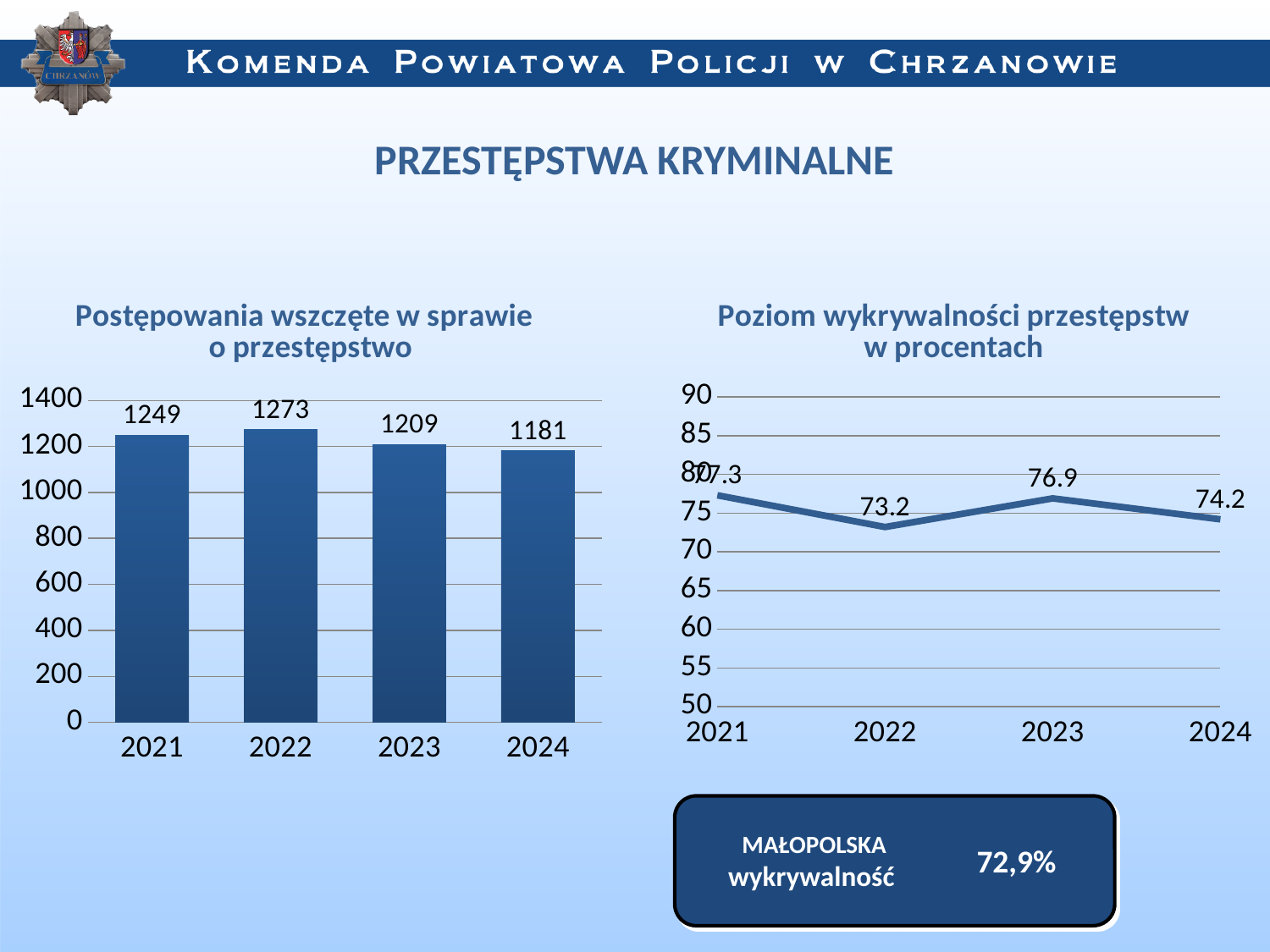
In the chart titled "Postępowania wszczęte w sprawie o przestępstwo", what is the difference between the values for 2022 and 2024? 92 In the chart titled "Poziom wykrywalności przestępstw w procentach", what is the value for 2023? 76.9 In the chart titled "Postępowania wszczęte w sprawie o przestępstwo", how many years are shown? 4 In the chart titled "Poziom wykrywalności przestępstw w procentach", what is the value for 2022? 73.2 In the chart titled "Postępowania wszczęte w sprawie o przestępstwo", what is the value for 2022? 1273 What kind of chart is the one titled "Postępowania wszczęte w sprawie o przestępstwo"? bar chart In the chart titled "Postępowania wszczęte w sprawie o przestępstwo", what is the value for 2024? 1181 In the chart titled "Poziom wykrywalności przestępstw w procentach", is the value for 2021 greater or less than 75? greater In the chart titled "Postępowania wszczęte w sprawie o przestępstwo", which year has the highest value? 2022 In the chart titled "Postępowania wszczęte w sprawie o przestępstwo", which year has the lowest value? 2024 In the chart titled "Poziom wykrywalności przestępstw w procentach", which year has the lowest value? 2022 What kind of chart is the one titled "Poziom wykrywalności przestępstw w procentach"? line chart